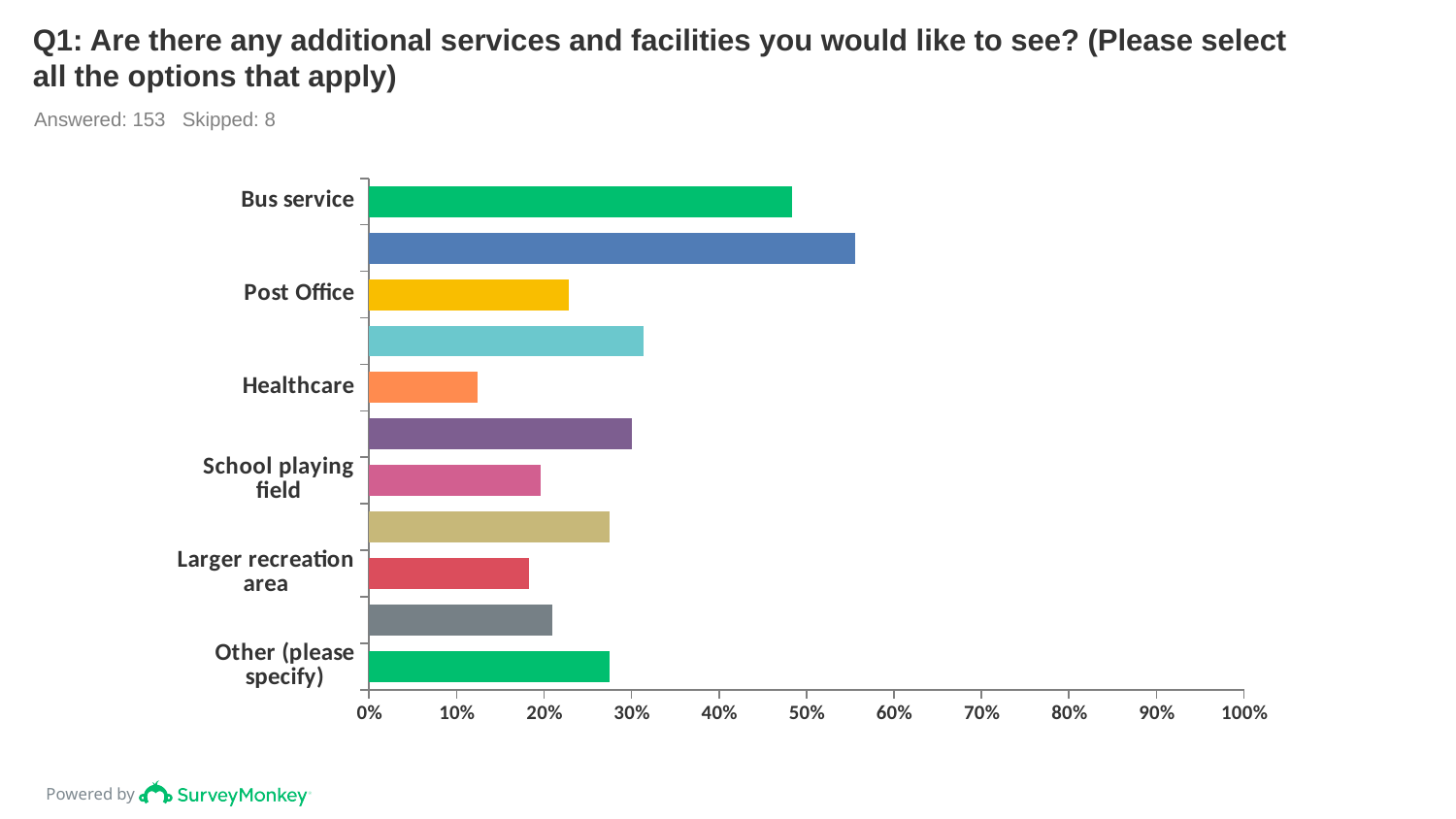
Is the value for Other (please specify) greater or less than 20%? greater Is the value for School playing field greater or less than 10%? greater Is the value for Bus service greater or less than 40%? greater Which is larger, the value for Bus service or the value for Post Office? Bus service What kind of chart is shown on the slide? bar chart What is the highest value shown on the x axis? 100% How many bars are plotted in the chart? 11 Which is larger, the value for Healthcare or the value for Other (please specify)? Other (please specify) Which labelled category has the lowest value? Healthcare